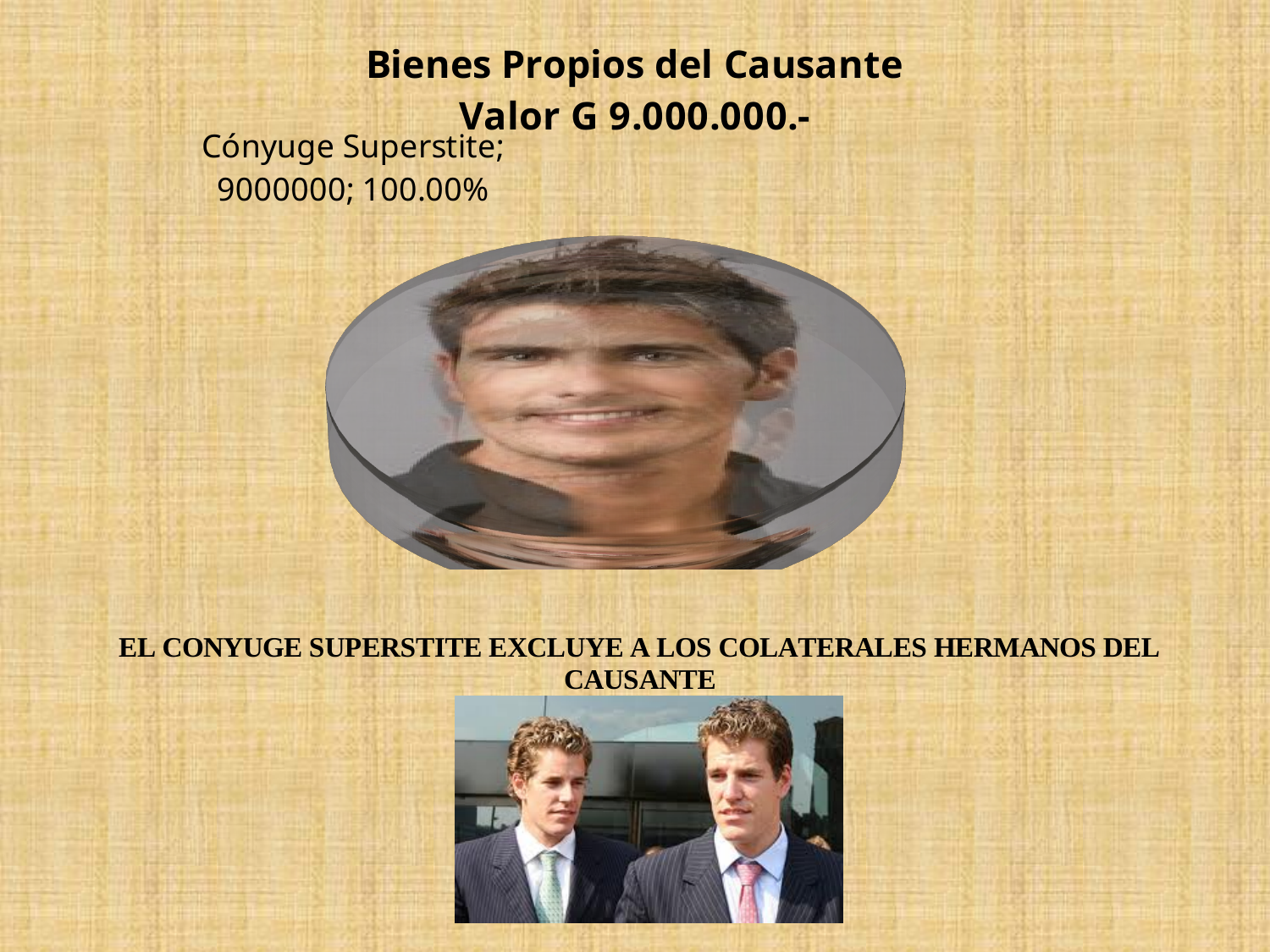
What is the value shown for Cónyuge Superstite? 9000000 What is the total value shown in the chart title? G 9.000.000.- What share of the pie does Cónyuge Superstite represent? 100.00% Is the value for Cónyuge Superstite greater or less than 5000000? greater What kind of chart is shown on the slide? pie chart How many slices does the pie chart have? 1 Which category is the only one plotted in the pie chart? Cónyuge Superstite What is the title of the chart? Bienes Propios del Causante Valor G 9.000.000.-